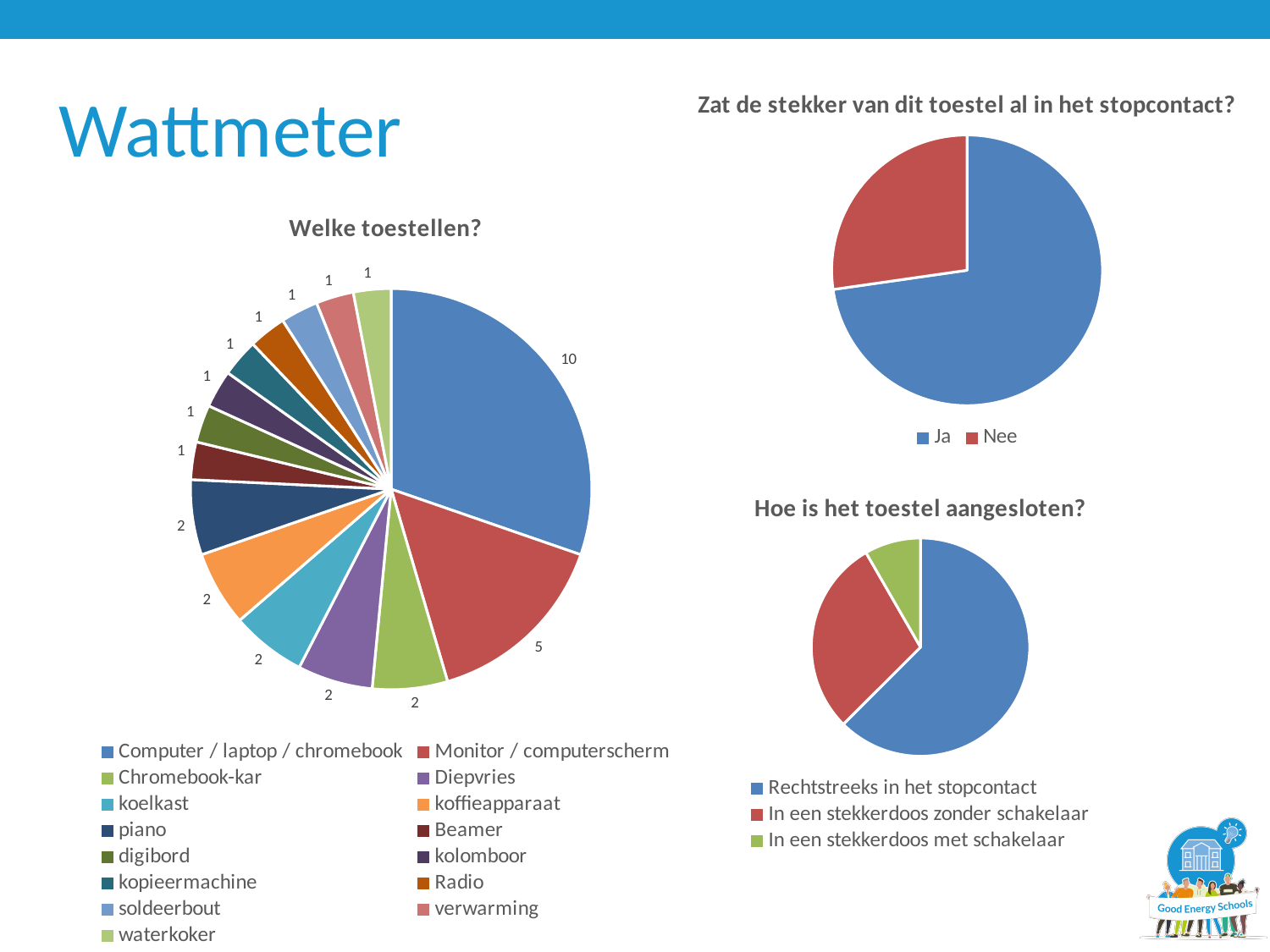
In the 'Welke toestellen?' pie chart, which category has the largest slice? Computer / laptop / chromebook In the 'Hoe is het toestel aangesloten?' pie chart, which category has the smallest slice? In een stekkerdoos met schakelaar In the 'Welke toestellen?' pie chart, what is the difference between the values for Computer / laptop / chromebook and Monitor / computerscherm? 5 In the 'Welke toestellen?' pie chart, what is the value for Monitor / computerscherm? 5 In the 'Welke toestellen?' pie chart, how many categories are shown? 15 What kind of chart is 'Welke toestellen?'? pie chart In the 'Welke toestellen?' pie chart, what is the total of all the slice values? 33 In the 'Zat de stekker van dit toestel al in het stopcontact?' pie chart, which slice is larger: Ja or Nee? Ja How many entries does the legend of the 'Zat de stekker van dit toestel al in het stopcontact?' pie chart list? 2 In the 'Welke toestellen?' pie chart, which is larger: Monitor / computerscherm or koelkast? Monitor / computerscherm In the 'Hoe is het toestel aangesloten?' pie chart, which category has the largest slice? Rechtstreeks in het stopcontact In the 'Welke toestellen?' pie chart, what is the value for Computer / laptop / chromebook? 10